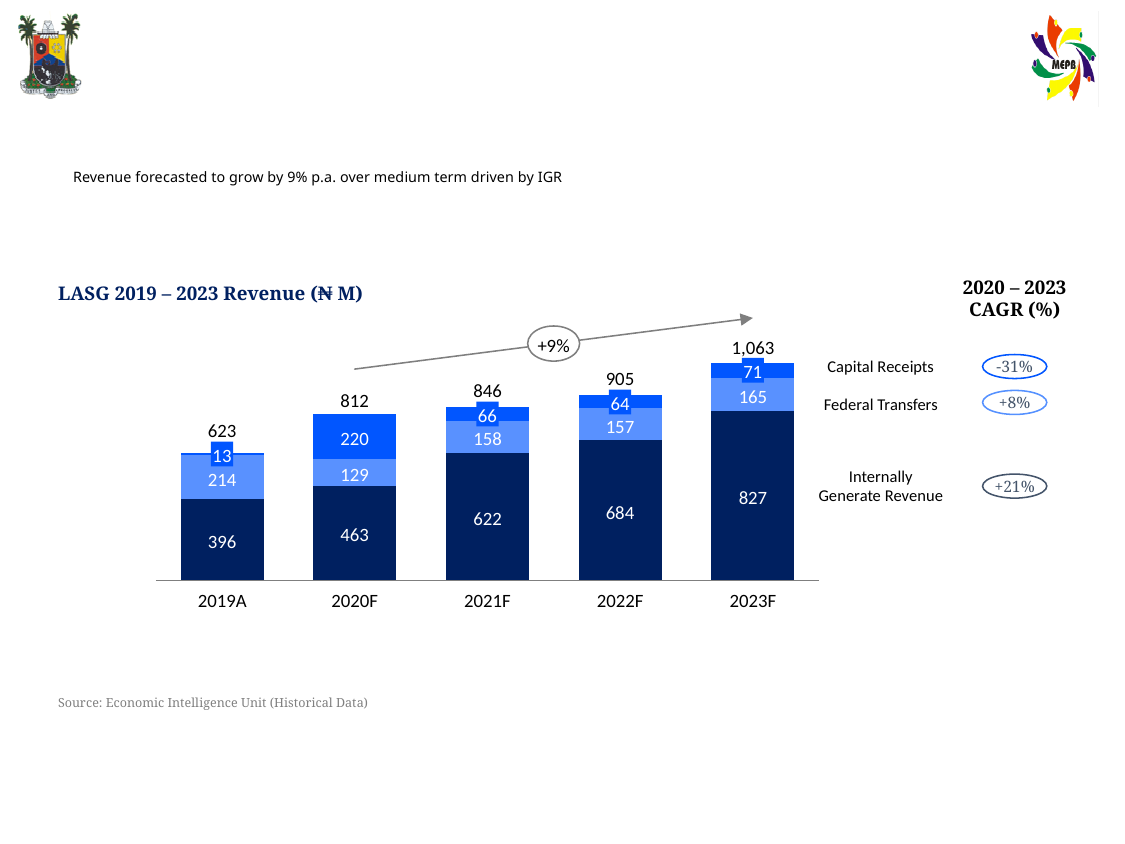
What type of chart is shown on the slide? Stacked bar chart Which is larger, the Internally Generated Revenue for 2022F or for 2021F? 2022F How many years are shown on the x axis? 5 Which year has the highest total revenue? 2023F Which year has the lowest total revenue? 2019A What is the 2020 – 2023 CAGR shown for Internally Generate Revenue? +21% Do the total revenue values rise or fall from 2019A to 2023F? Rise What is the Internally Generated Revenue value for 2021F? 622 What is the difference between the total revenue for 2020F and 2019A? 189 What is the Federal Transfers value for 2019A? 214 What is the total revenue shown for 2023F? 1,063 What is the Capital Receipts value for 2020F? 220